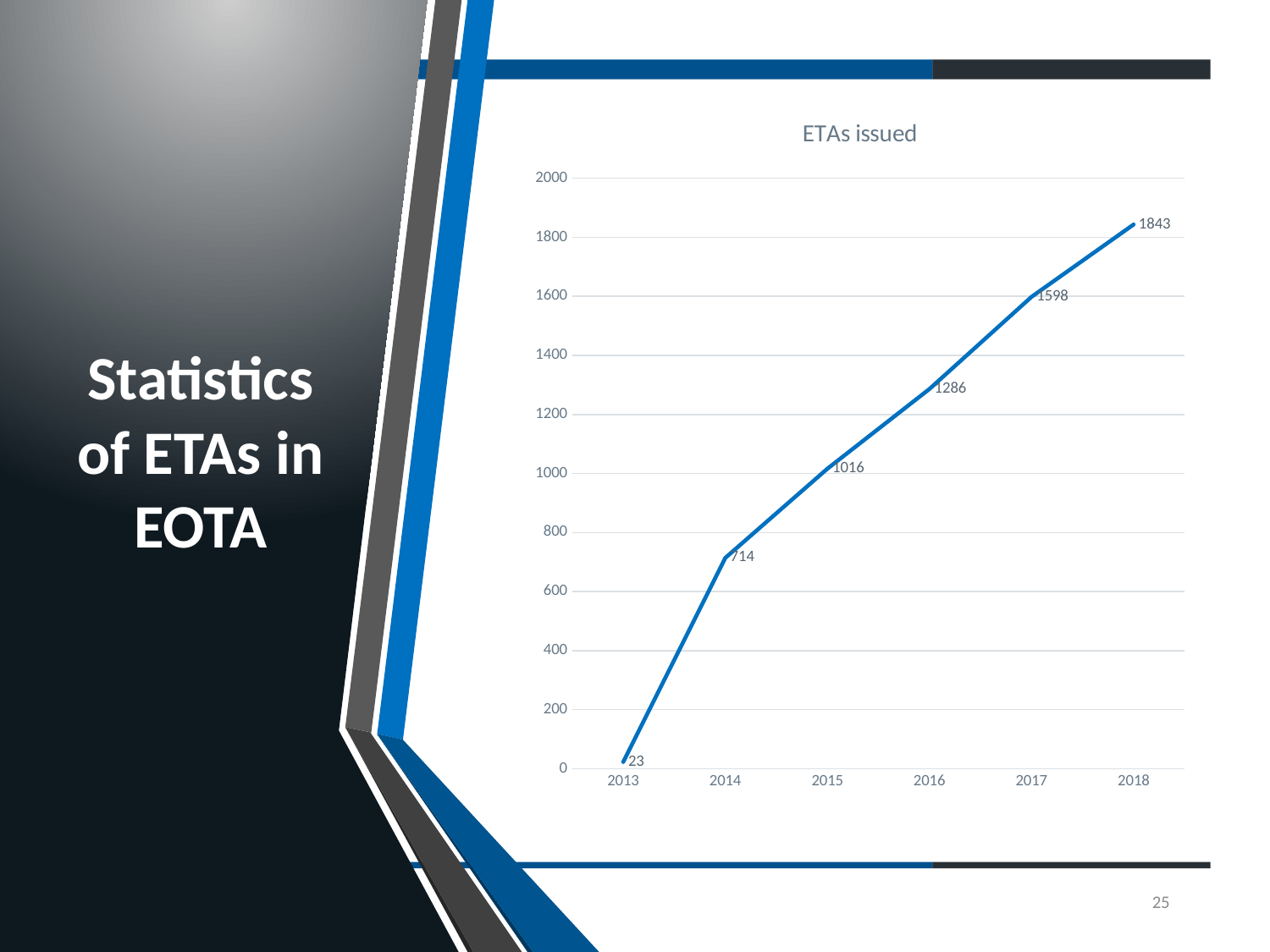
What kind of chart is shown on the slide? line chart What is the value for 2016 in the ETAs issued chart? 1286 Which is larger, the value for 2015 or the value for 2016? 2016 What is the difference between the values for 2018 and 2017? 245 What is the value for 2018 in the ETAs issued chart? 1843 Do the values rise or fall from 2013 to 2018? rise Which year has the lowest number of ETAs issued? 2013 What is the difference between the values for 2014 and 2013? 691 How many years are plotted on the x axis? 6 Is the value for 2017 greater or less than 1400? greater Which year has the highest number of ETAs issued? 2018 What is the value for 2013 in the ETAs issued chart? 23